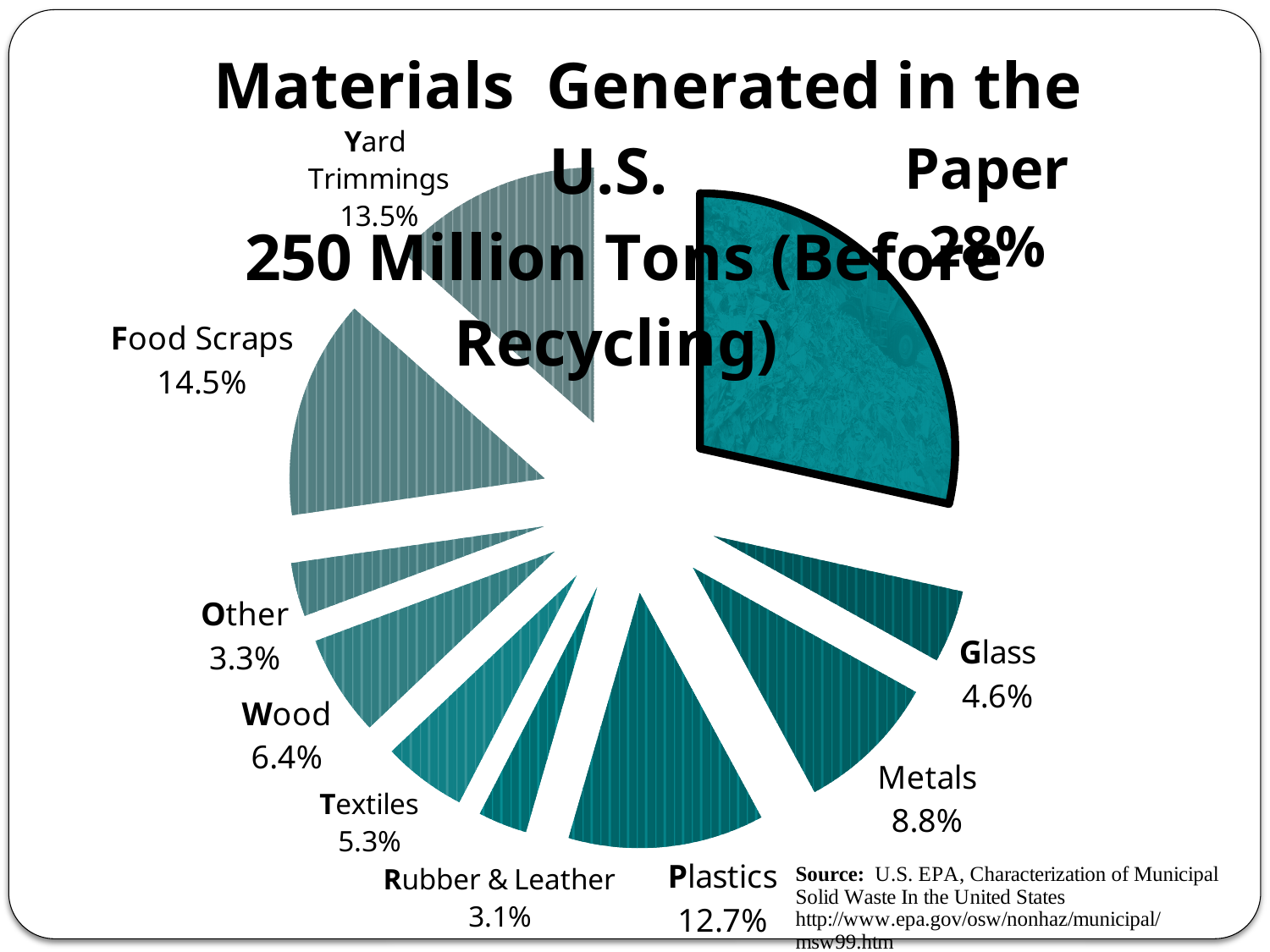
What percentage is shown for Plastics? 12.7% What share of materials generated is Food Scraps? 14.5% What share does Metals account for? 8.8% What percentage is shown for Yard Trimmings? 13.5% What percentage is shown for Rubber & Leather? 3.1% How many material categories are shown in the pie chart? 10 According to the chart title, how many million tons of materials were generated in the U.S. before recycling? 250 Million Tons Which material has the largest share of the pie? Paper Which material has the smallest share of the pie? Rubber & Leather What is the difference in percentage points between Food Scraps and Yard Trimmings? 1.0 Which has a larger share, Wood or Textiles? Wood What type of chart is shown on the slide? pie chart